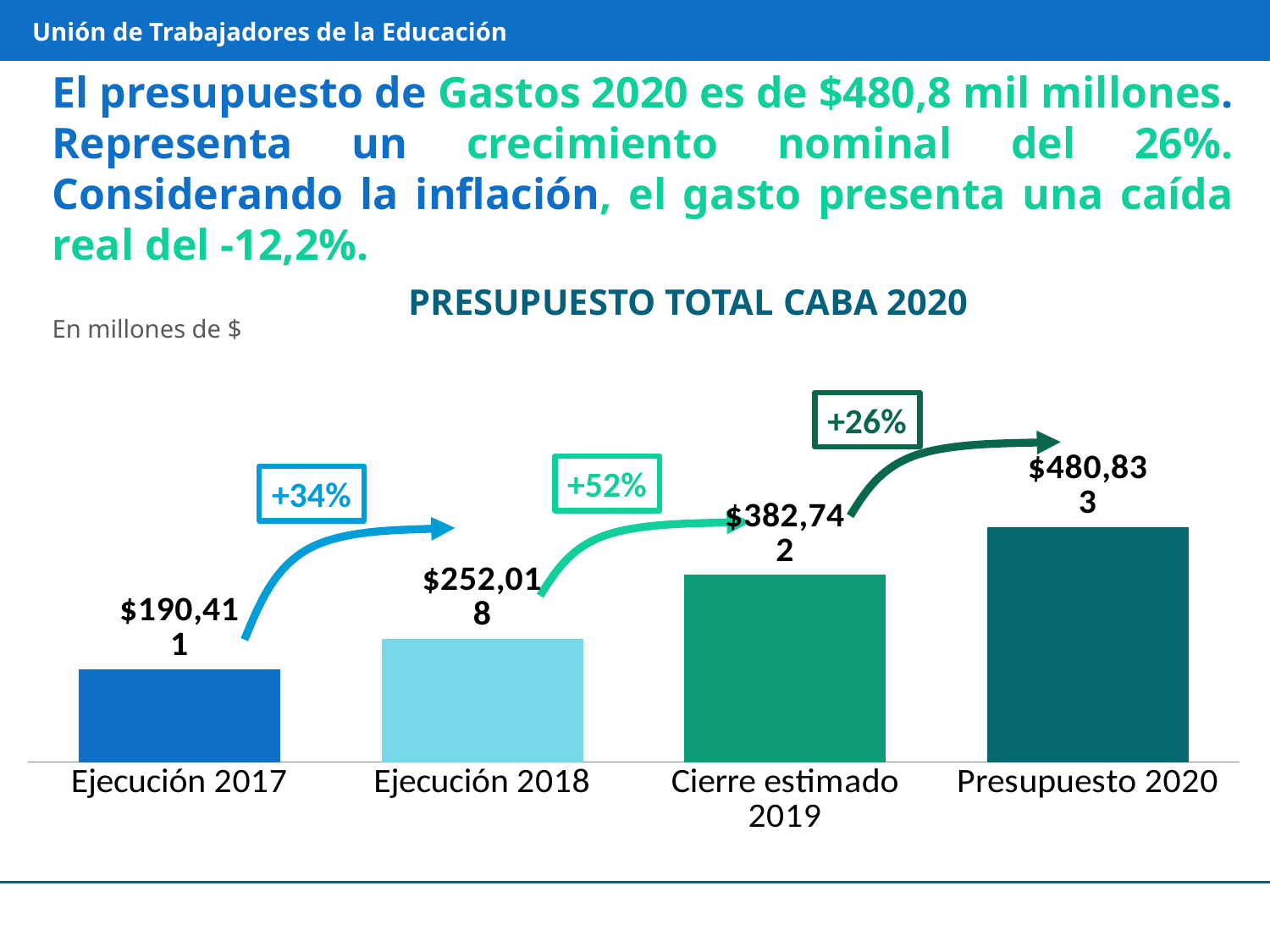
Which category has the highest value in the PRESUPUESTO TOTAL CABA 2020 chart? Presupuesto 2020 What is the value for Ejecución 2017 in the PRESUPUESTO TOTAL CABA 2020 chart? $190,411 What kind of chart is PRESUPUESTO TOTAL CABA 2020? Bar chart What is the value for Presupuesto 2020 in the PRESUPUESTO TOTAL CABA 2020 chart? $480,833 Which is larger, the value for Cierre estimado 2019 or the value for Ejecución 2018? Cierre estimado 2019 What is the difference between the values for Ejecución 2018 and Ejecución 2017? $61,607 Which category has the lowest value in the PRESUPUESTO TOTAL CABA 2020 chart? Ejecución 2017 What is the difference between the values for Presupuesto 2020 and Cierre estimado 2019? $98,091 What percentage growth is annotated between Ejecución 2018 and Cierre estimado 2019? +52% What is the value for Cierre estimado 2019 in the PRESUPUESTO TOTAL CABA 2020 chart? $382,742 How many categories are shown in the PRESUPUESTO TOTAL CABA 2020 chart? 4 What is the value for Ejecución 2018 in the PRESUPUESTO TOTAL CABA 2020 chart? $252,018